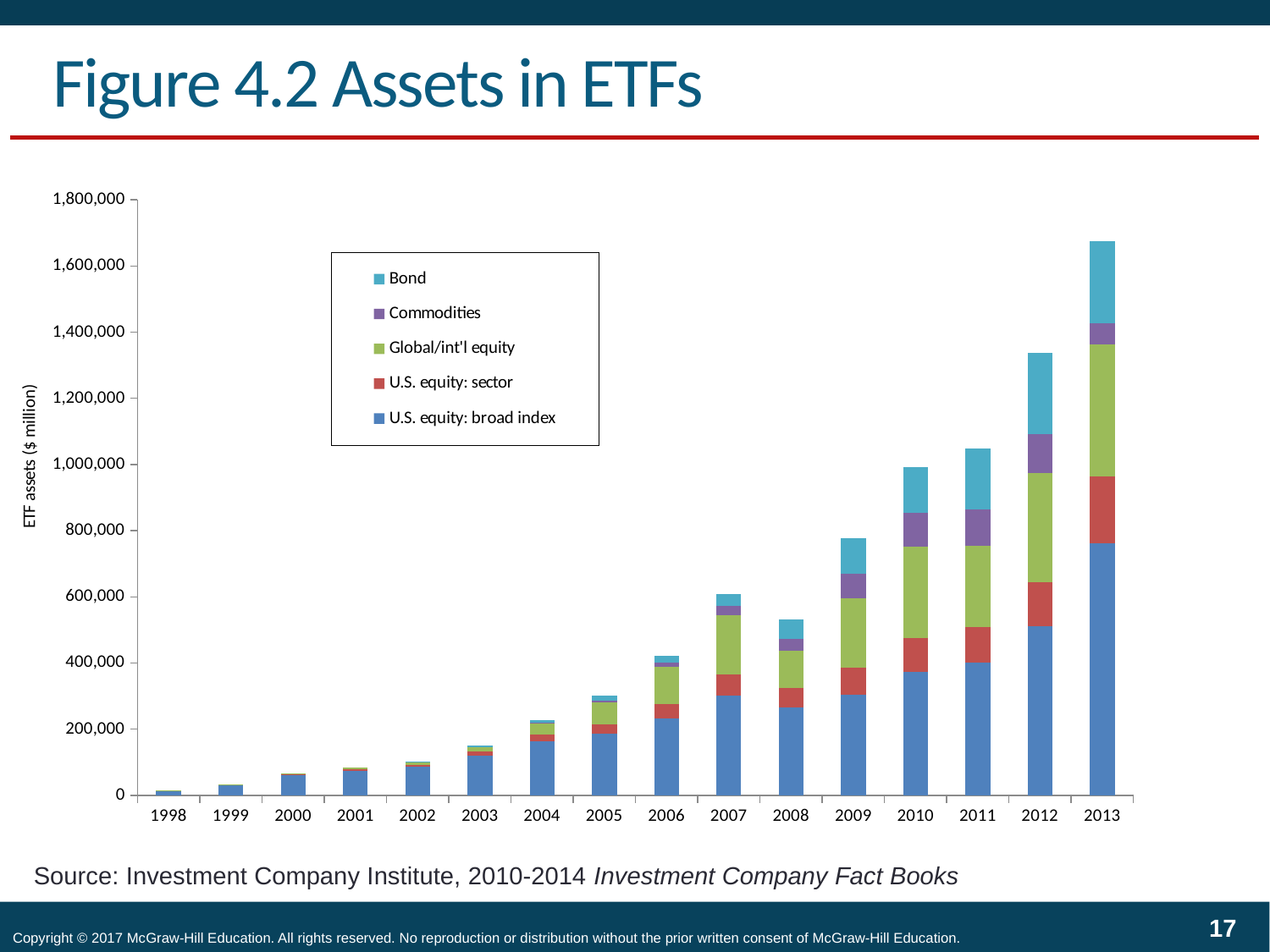
Is the total ETF assets for 2008 greater or less than 600,000? less What kind of chart is shown on the slide? Stacked bar chart Which year has larger total ETF assets, 2007 or 2008? 2007 How many series does the legend list? 5 Is the total ETF assets for 2003 greater or less than 200,000? less How many years are shown on the x axis? 16 Is the total ETF assets for 2013 greater or less than 1,600,000? greater Do total ETF assets generally rise or fall from 1998 to 2013? rise Which year has the highest total ETF assets? 2013 Which year has the lowest total ETF assets? 1998 What is the label on the y axis? ETF assets ($ million)